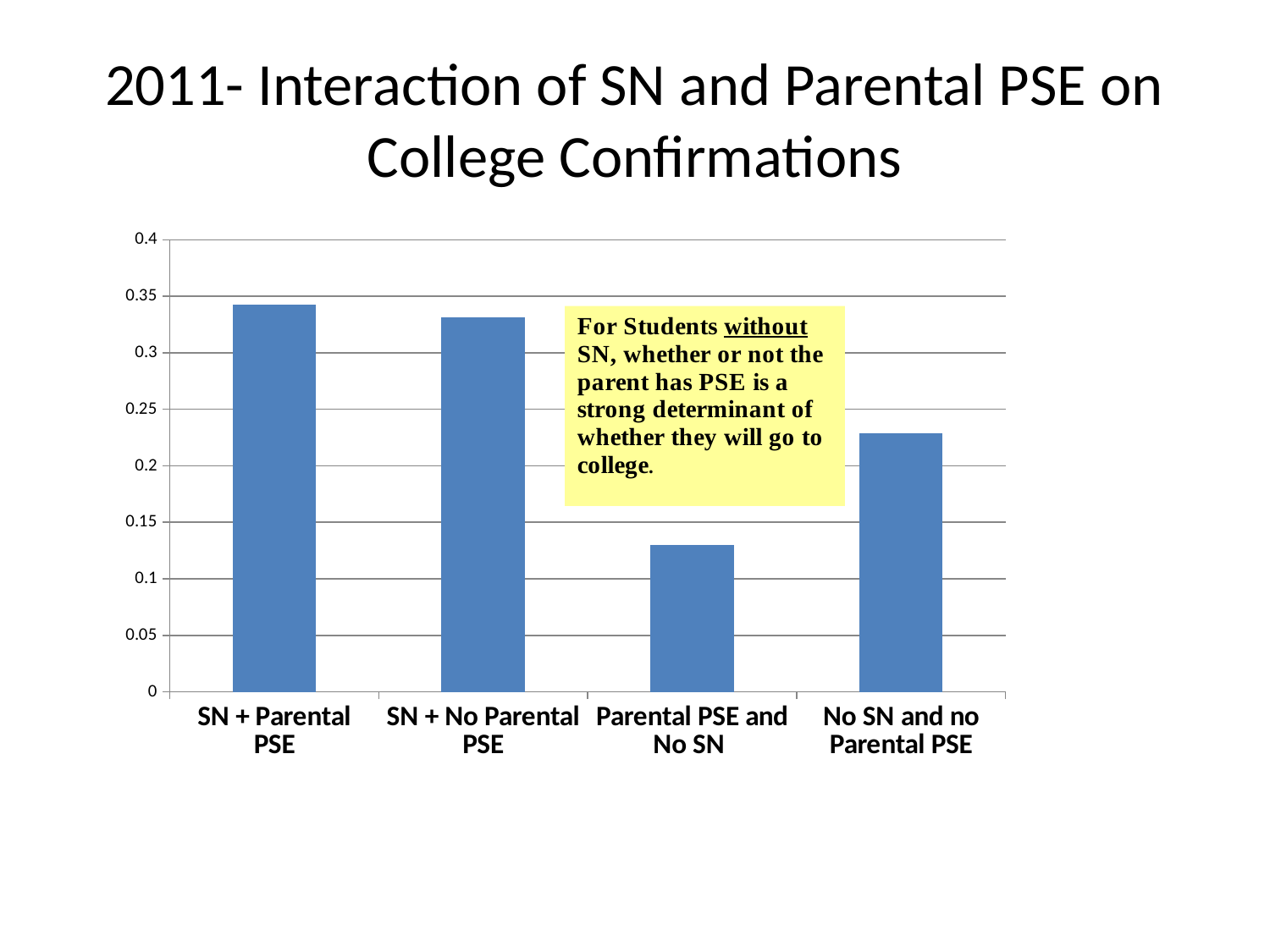
Is the value for Parental PSE and No SN greater or less than 0.1? greater Is the value for Parental PSE and No SN greater or less than 0.15? less What is the highest value shown on the y axis of the chart? 0.4 How many categories are shown on the x axis of the chart? 4 Is the value for No SN and no Parental PSE greater or less than 0.25? less What kind of chart is shown on the slide? bar chart Which category has the lowest value in the chart? Parental PSE and No SN Which is larger, the value for SN + No Parental PSE or the value for No SN and no Parental PSE? SN + No Parental PSE Which is larger, the value for Parental PSE and No SN or the value for No SN and no Parental PSE? No SN and no Parental PSE